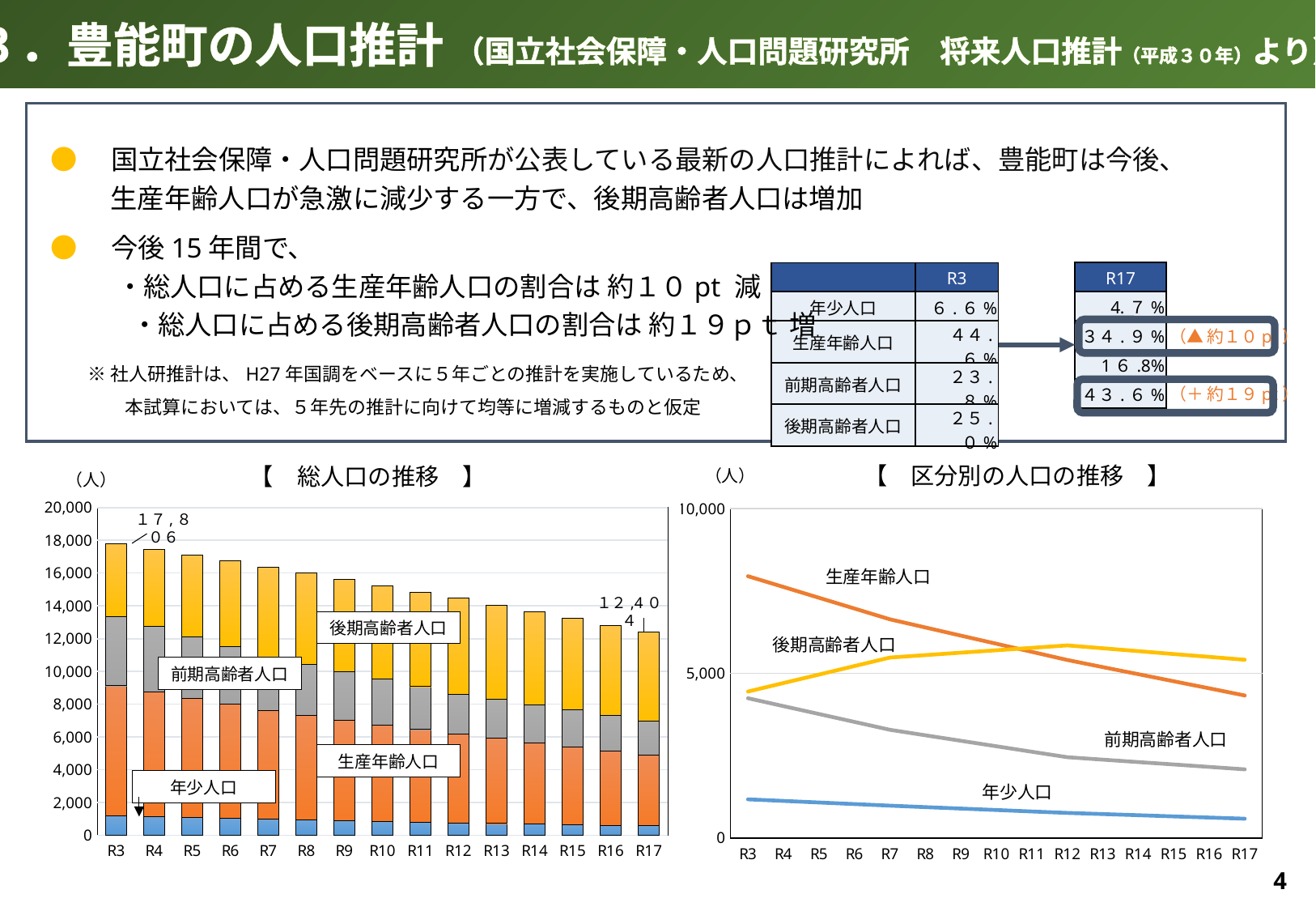
In the 区分別の人口の推移 chart, which group has the lowest value at R17? 年少人口 In the 区分別の人口の推移 chart, does the 後期高齢者人口 line rise or fall from R3 to R12? rise What kind of chart is the 区分別の人口の推移 chart on the right? line chart In the 総人口の推移 chart, what is the difference between the R3 total (17,806) and the R17 total (12,404)? 5,402 In the 総人口の推移 chart, what is the total population labelled for R17? 12,404 How many years (categories) are shown on the x axis of the 総人口の推移 chart? 15 What kind of chart is the 総人口の推移 chart on the left? bar chart In the 区分別の人口の推移 chart, which group has the highest value at R3? 生産年齢人口 In the 総人口の推移 chart, is the total for R17 greater or less than 14,000? less How many population groups (lines) are plotted in the 区分別の人口の推移 chart? 4 In the 総人口の推移 chart, what is the total population labelled for R3? 17,806 In the 総人口の推移 chart, does the total population rise or fall from R3 to R17? fall